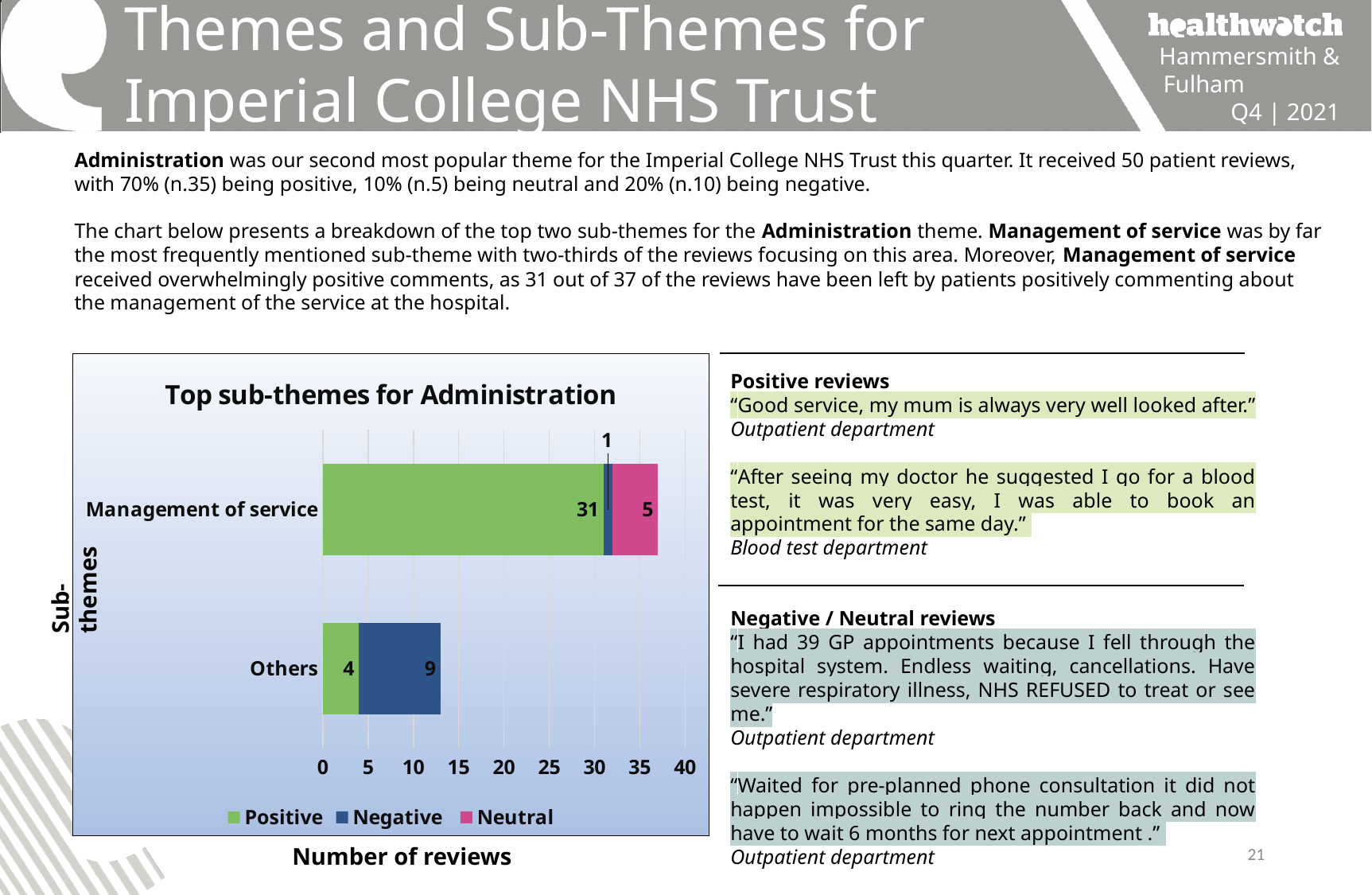
What type of chart is shown on the slide? Stacked bar chart Which sub-theme has the longer bar overall? Management of service What is the total number of reviews in the Management of service bar? 37 How many sub-theme categories are plotted in the chart? 2 What is the total number of reviews in the Others bar? 13 What is the difference between the positive reviews for Management of service and the positive reviews for Others? 27 How many negative reviews are shown for Others? 9 How many neutral reviews are shown for Management of service? 5 What is the title of the chart? Top sub-themes for Administration How many series does the chart legend list? 3 How many positive reviews are shown for Management of service? 31 How many negative reviews are shown for Management of service? 1